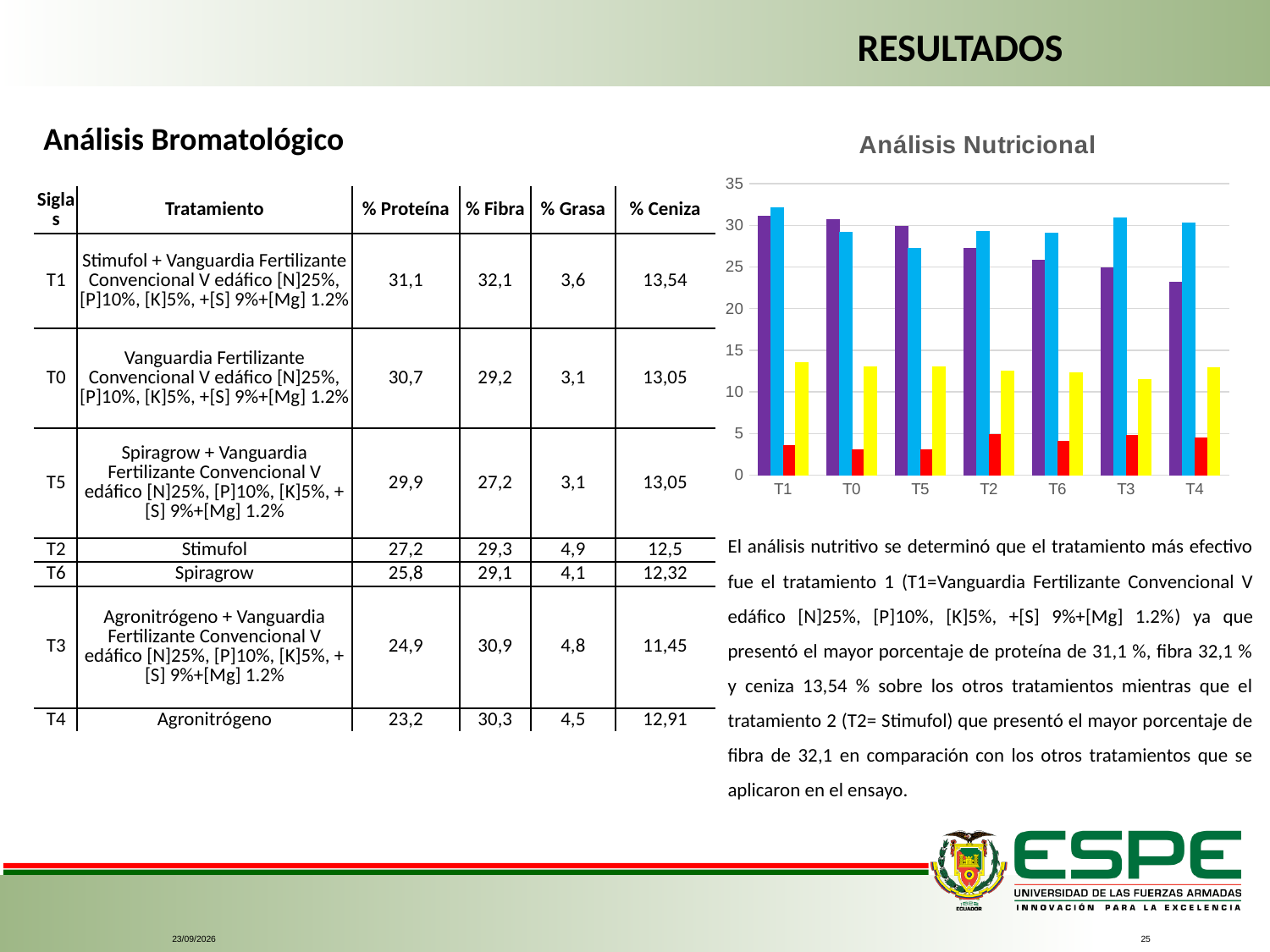
In the 'Análisis Nutricional' chart, do the purple bars rise or fall from T1 to T4? fall What is the highest tick value shown on the y axis of the 'Análisis Nutricional' chart? 35 In the 'Análisis Nutricional' chart, is the tallest bar for T1 greater or less than 30? greater How many categories are shown on the x axis of the 'Análisis Nutricional' chart? 7 In the 'Análisis Nutricional' chart, for T4, which is taller: the purple bar or the blue bar? the blue bar In the 'Análisis Nutricional' chart, which category has the shortest purple bar? T4 What kind of chart is the 'Análisis Nutricional' chart? bar chart In the 'Análisis Nutricional' chart, is the shortest bar for T1 greater or less than 5? less What is the title of the chart on the slide? Análisis Nutricional In the 'Análisis Nutricional' chart, is the yellow bar for T1 greater or less than 10? greater